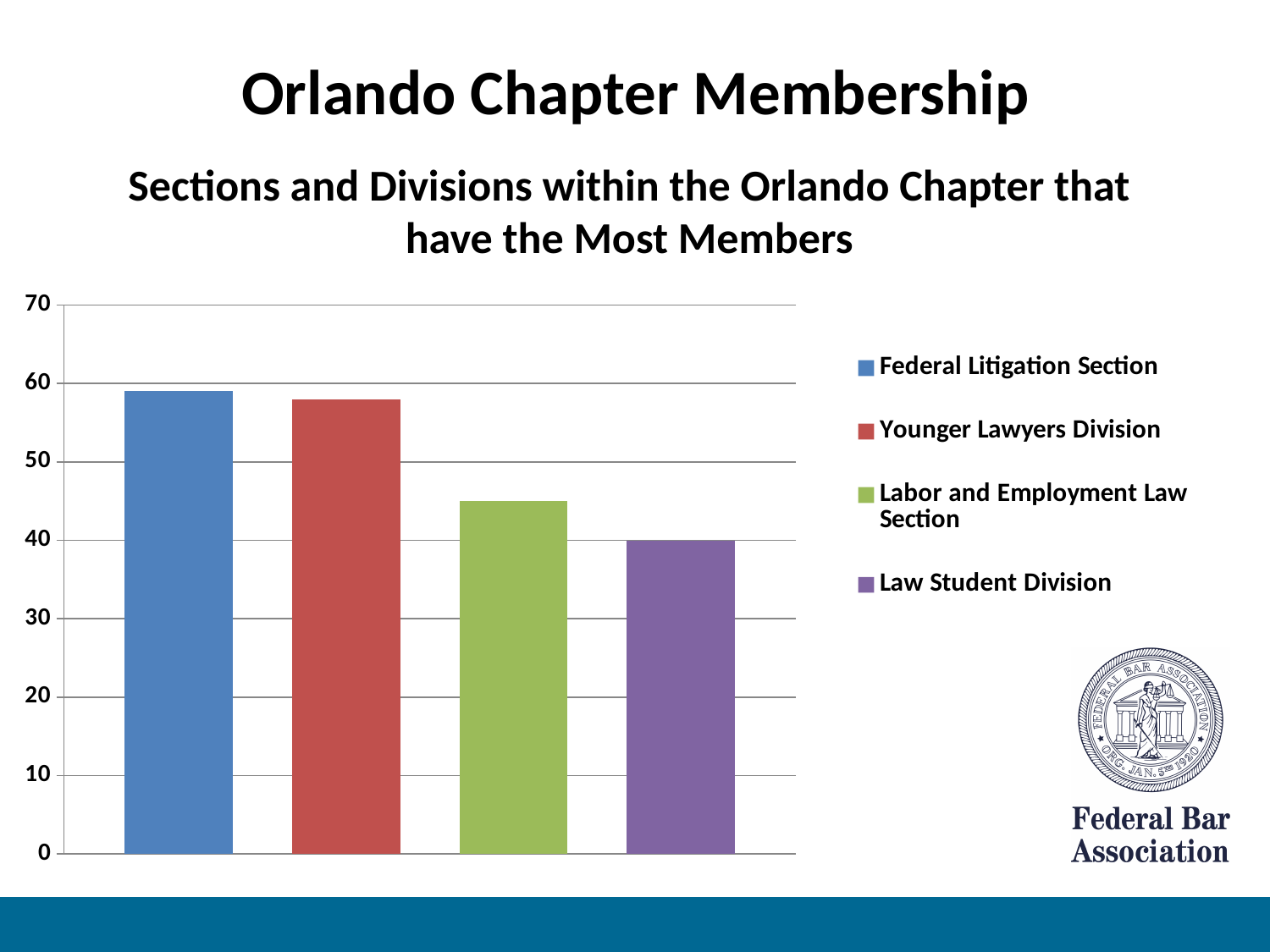
Is the value for the Labor and Employment Law Section greater or less than 40? greater What kind of chart is shown on the slide? bar chart Which section or division has the lowest value in the chart? Law Student Division Which is larger, the value for the Younger Lawyers Division or the value for the Law Student Division? Younger Lawyers Division Which is larger, the value for the Federal Litigation Section or the value for the Labor and Employment Law Section? Federal Litigation Section Is the value for the Younger Lawyers Division greater or less than 60? less Do the bar values rise or fall from left to right across the chart? fall What colour is the bar for the Labor and Employment Law Section? green How many bars are plotted in the chart? 4 What is the value for the Law Student Division? 40 How many entries does the legend list? 4 Is the value for the Federal Litigation Section greater or less than 50? greater